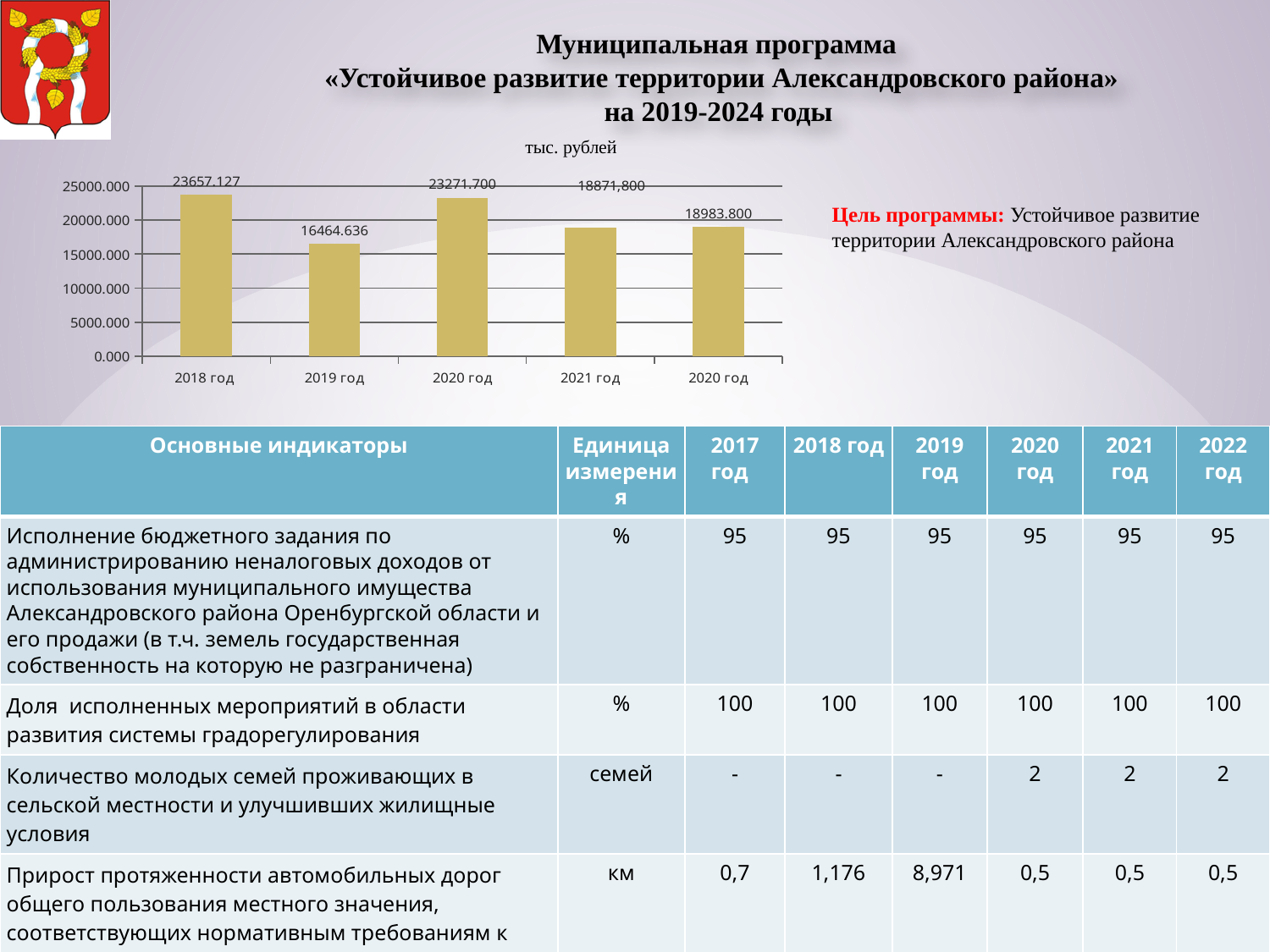
What is the value for 2019 год in the bar chart? 16464.636 Which year has the lowest value in the bar chart? 2019 год How many bars are shown in the bar chart? 5 What is the value for 2021 год in the bar chart? 18871,800 What unit is indicated above the bar chart? тыс. рублей Is the value for 2019 год in the bar chart greater or less than 20000.000? less Which is larger in the bar chart: the value for 2019 год or the value for 2021 год? 2021 год Which bar has the highest value in the bar chart? 2018 год What is the value of the third bar from the left (labelled 2020 год) in the bar chart? 23271.700 What type of chart is shown on the slide? bar chart What is the value for 2018 год in the bar chart? 23657.127 What is the difference between the values for 2018 год and 2019 год in the bar chart? 7192.491